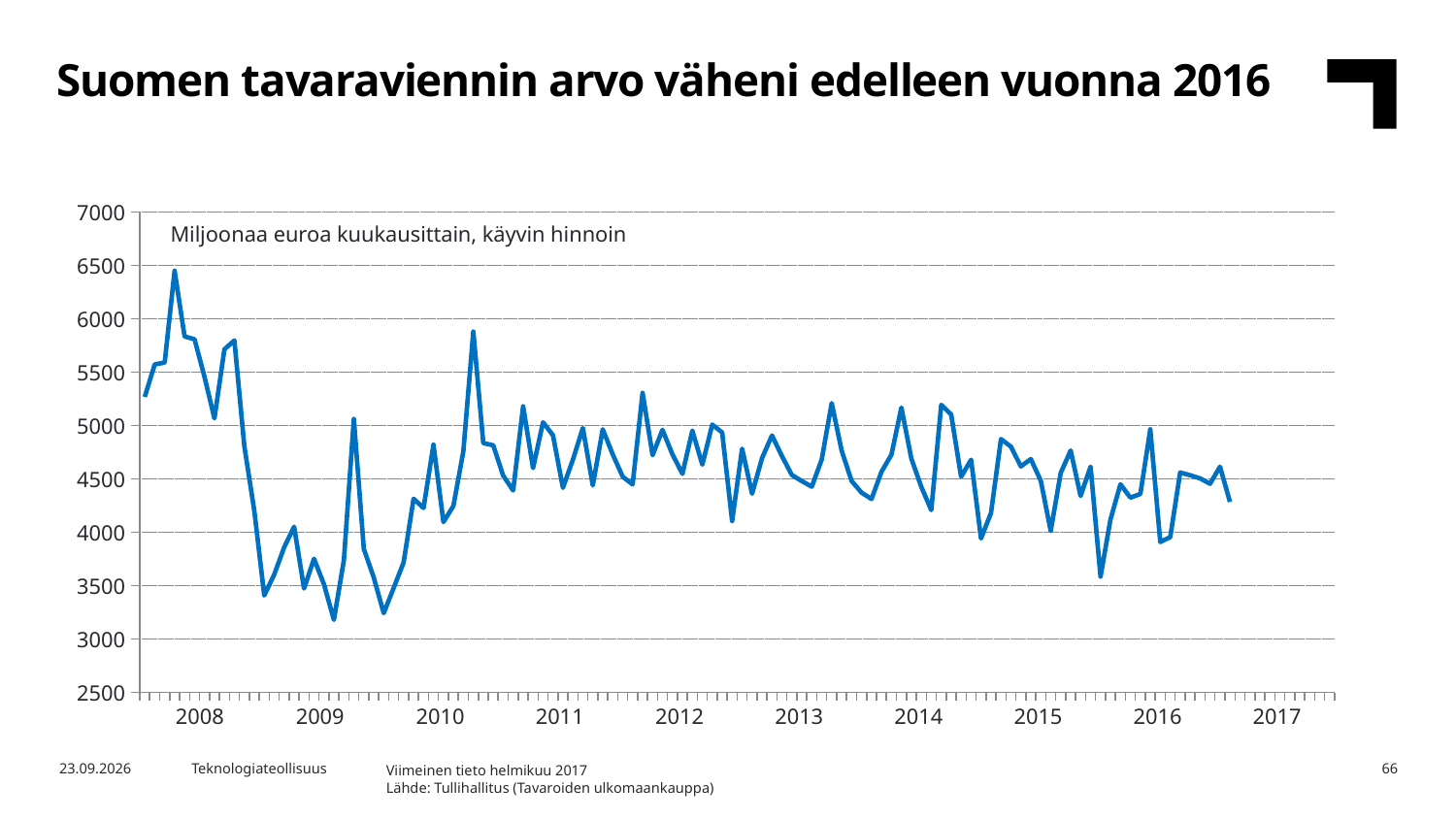
Is the peak value in early 2010 greater or less than 5500? greater What unit description is printed inside the chart area? Miljoonaa euroa kuukausittain, käyvin hinnoin What is the first year labelled on the x axis? 2008 Overall, does the line rise or fall from the start of 2008 to the end of 2016? fall What is the title of the slide? Suomen tavaraviennin arvo väheni edelleen vuonna 2016 Is the lowest point of the line in 2009 greater or less than 3500? less How many data series are plotted in the chart? 1 In which year does the line reach its lowest point? 2009 Is the lowest value in 2015 greater or less than 4000? less In which year does the line reach its highest peak? 2008 What kind of chart is shown on the slide? line chart